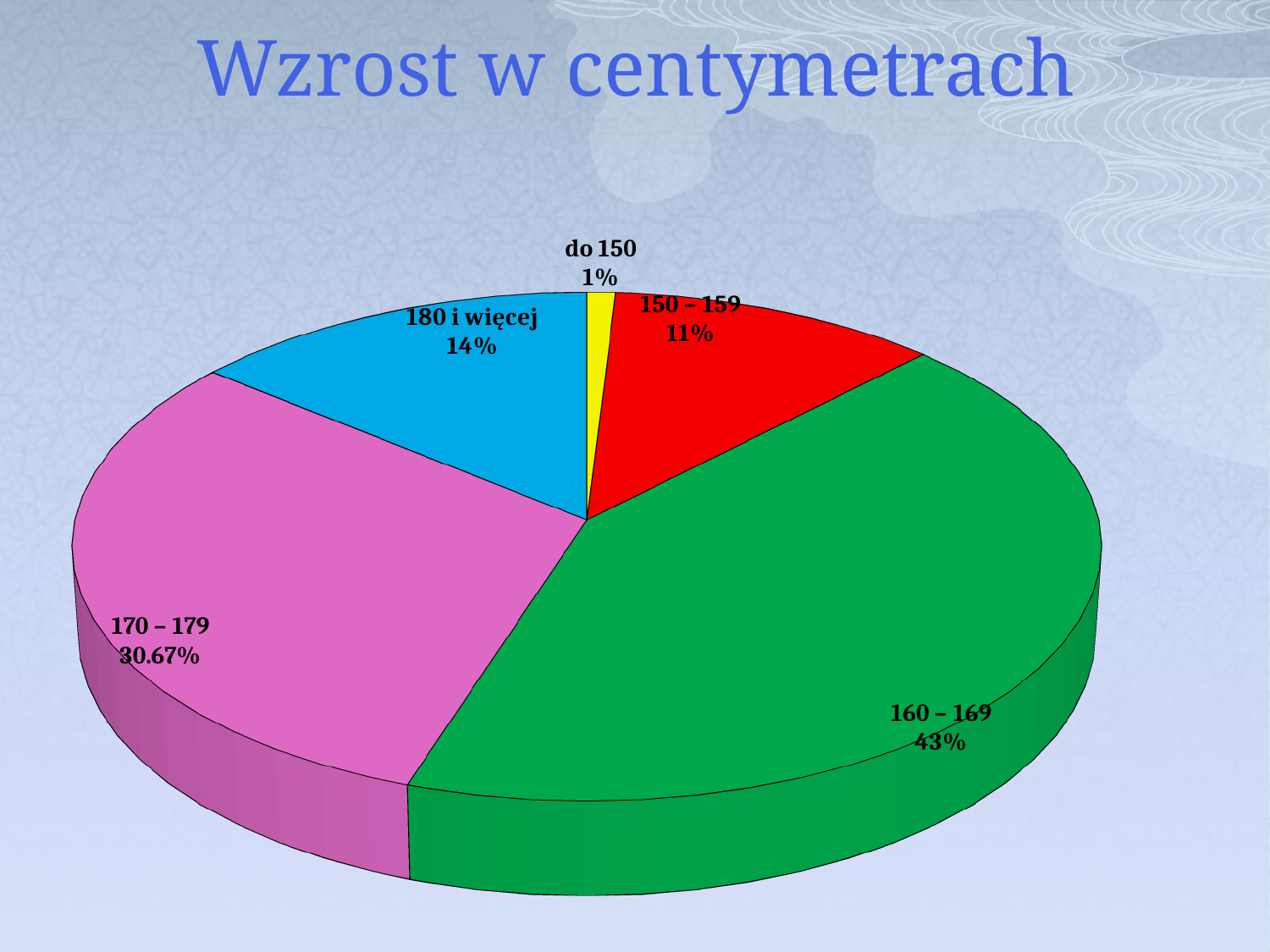
What is the value shown for the 180 i więcej slice? 14% Which category has the smallest share of the pie? do 150 What is the value shown for the 150 – 159 slice? 11% Which category has the largest share of the pie? 160 – 169 Which is larger, the share for 180 i więcej or the share for 150 – 159? 180 i więcej How many slices does the pie chart have? 5 What share of the pie does the 170 – 179 slice represent? 30.67% What share of the pie does the 160 – 169 slice represent? 43% What is the title of the chart? Wzrost w centymetrach What is the value shown for the do 150 slice? 1% What kind of chart is shown on the slide? pie chart What colour is the 160 – 169 slice? green